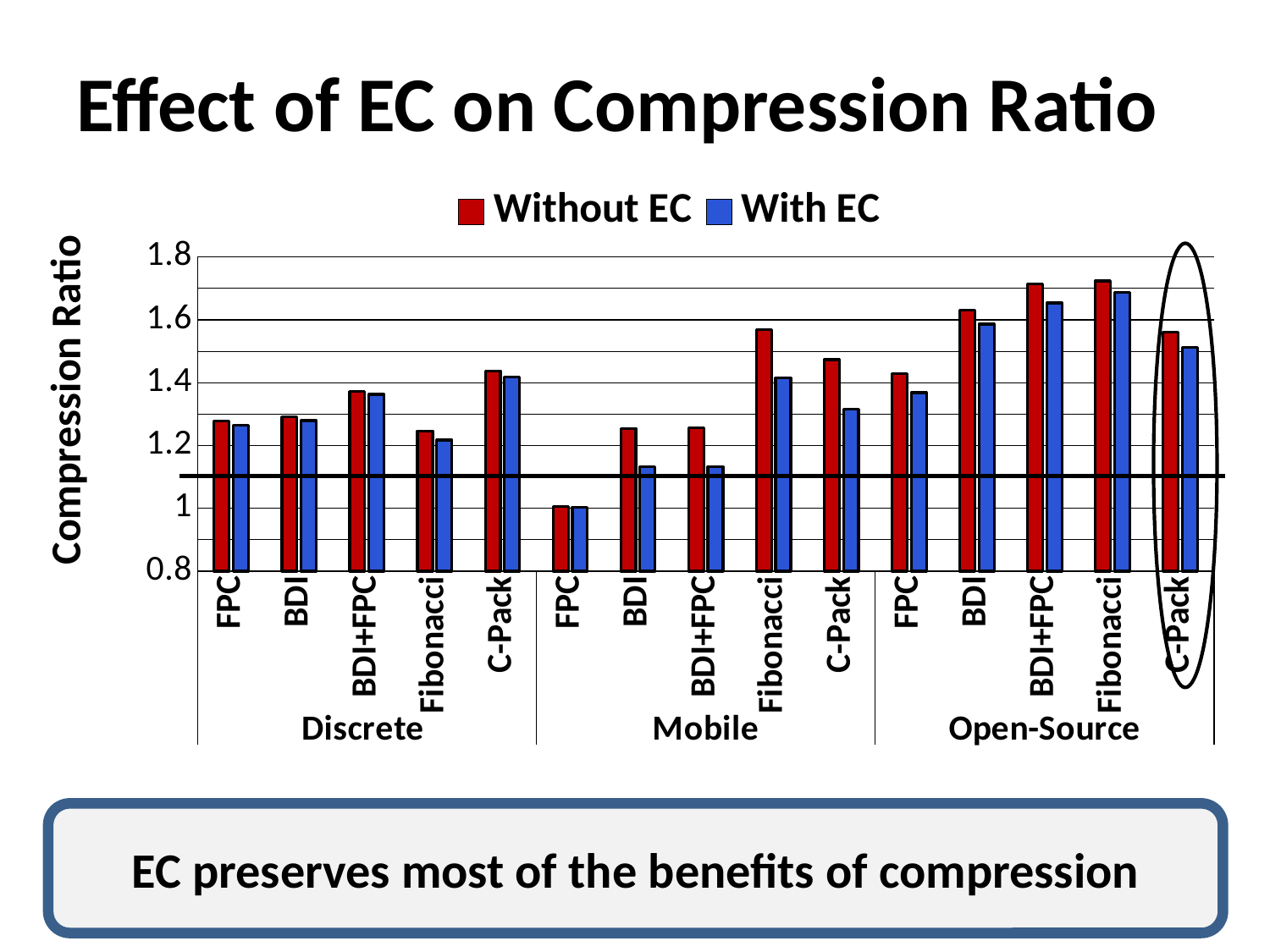
What kind of chart is shown on the slide? bar chart Which workload group has the highest compression ratios overall? Open-Source Which category has the lowest compression ratio in the chart? FPC in the Mobile group What are the two series named in the legend? Without EC and With EC How many workload groups are labelled along the x axis? 3 For Fibonacci in the Mobile group, which is larger: the Without EC value or the With EC value? Without EC How many compression-algorithm categories are plotted in total across all groups? 15 Is the Without EC value for BDI+FPC in the Open-Source group greater or less than 1.6? greater Is the With EC value for BDI in the Mobile group greater or less than 1.2? less Which category is circled on the chart? C-Pack in the Open-Source group Is the Without EC value for Fibonacci in the Mobile group greater or less than 1.4? greater How many series does the legend list? 2